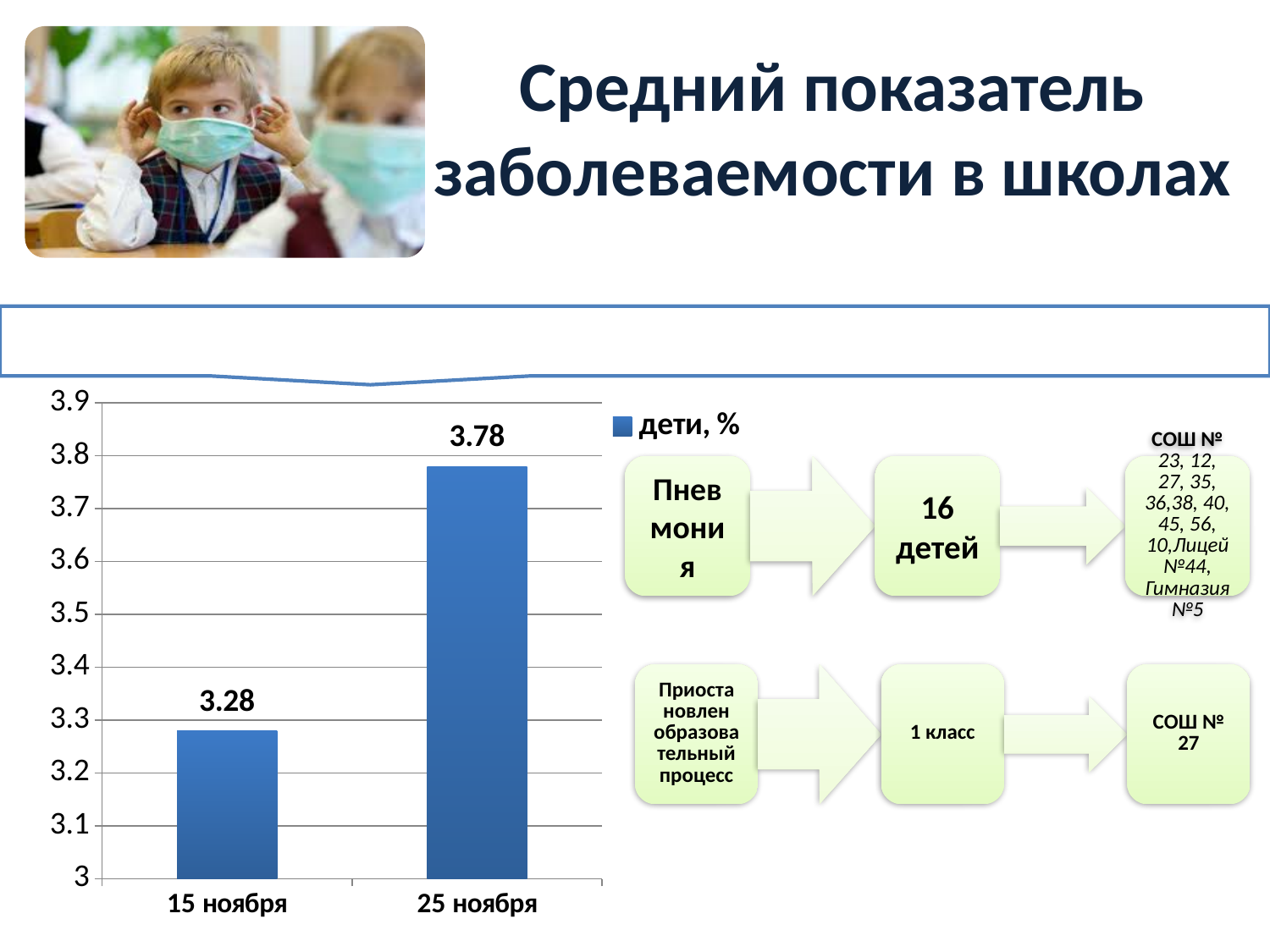
How many categories are shown on the x axis of the chart? 2 What is the value for 25 ноября? 3.78 Which category has the highest value? 25 ноября What is the difference between the values for 25 ноября and 15 ноября? 0.5 Is the value for 25 ноября greater or less than 3.7? greater Which category has the lowest value? 15 ноября What is the name of the series shown in the chart legend? дети, % Which is larger, the value for 15 ноября or the value for 25 ноября? 25 ноября Is the value for 15 ноября greater or less than 3.5? less How many series does the chart legend list? 1 What kind of chart is shown on the slide? bar chart What is the value for 15 ноября? 3.28